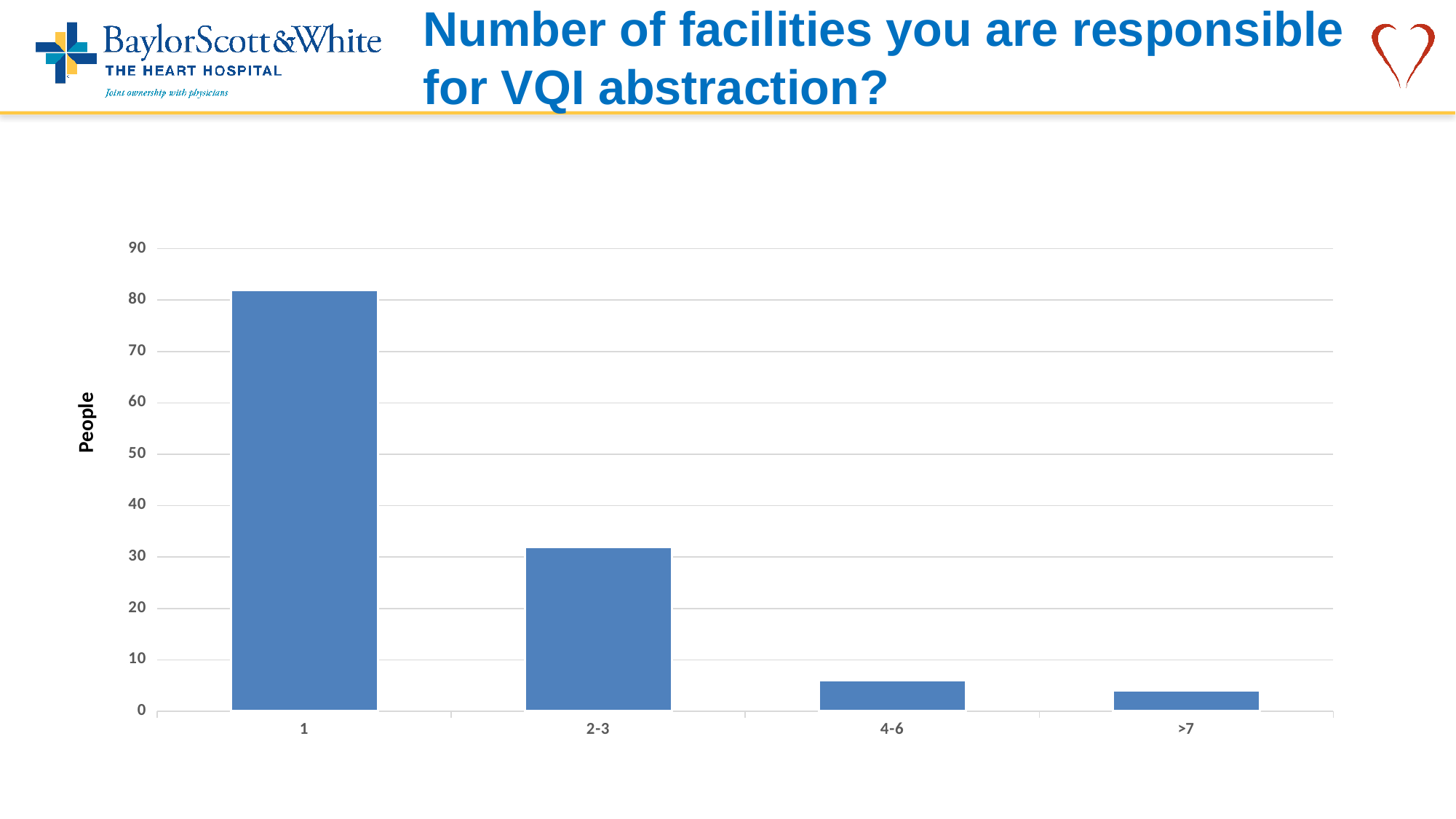
Do the values rise or fall moving from left to right along the x axis? fall What kind of chart is shown on the slide? bar chart Which is larger, the value for category 4-6 or the value for category >7? 4-6 What is the label on the vertical axis of the chart? People Is the value for category 2-3 greater or less than 20? greater Is the value for category 2-3 greater or less than 40? less Which is larger, the value for category 1 or the value for category 2-3? 1 Is the value for category 4-6 greater or less than 10? less How many categories are shown on the x axis of the chart? 4 Which category has the lowest number of people? >7 Which category has the highest number of people? 1